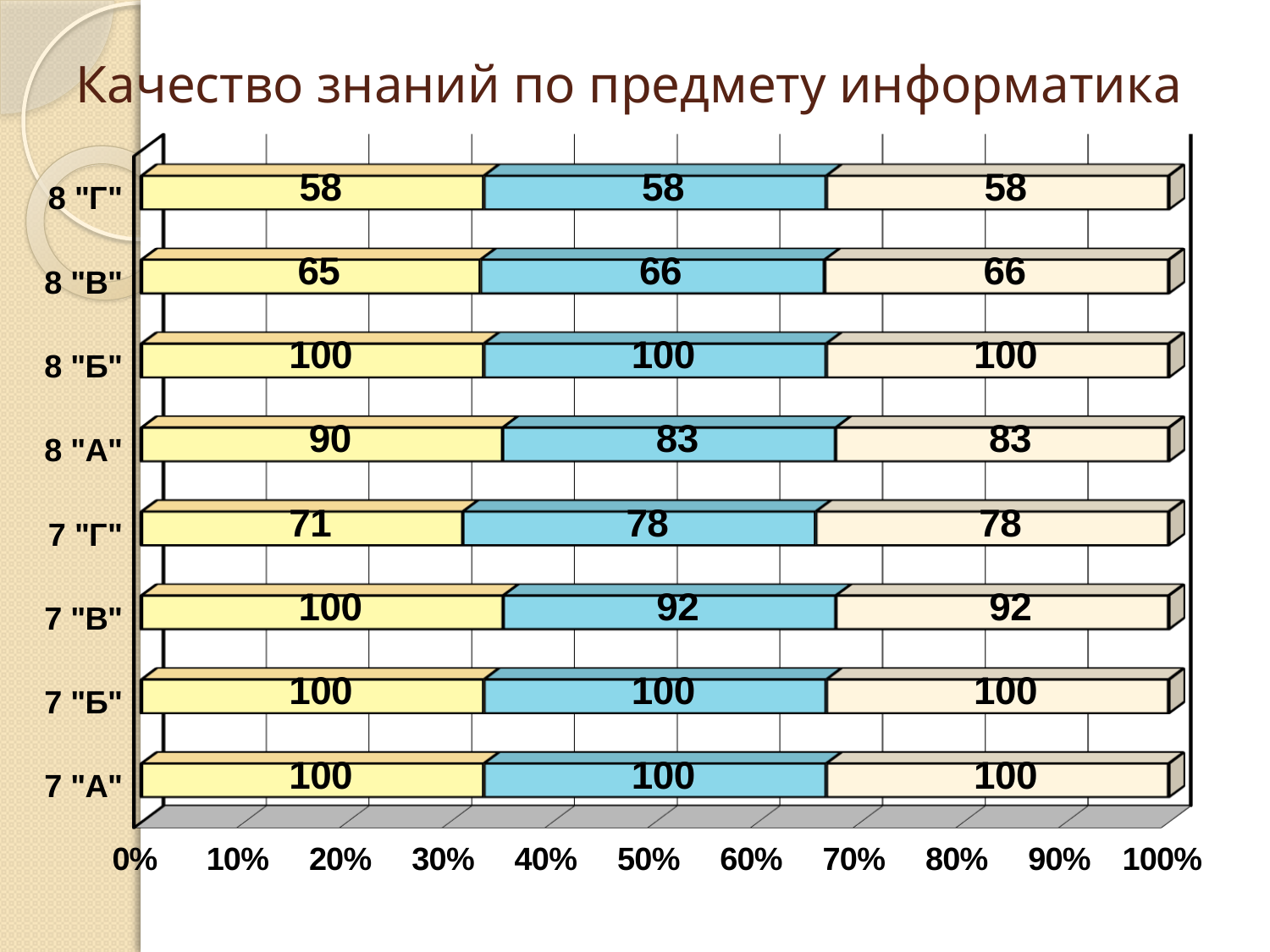
What is the value of the third (beige) segment for 7 "В"? 92 What is the value of the first (yellow) segment for 8 "А"? 90 For 7 "В", what is the difference between the yellow segment value and the blue segment value? 8 What is the title of the chart? Качество знаний по предмету информатика What is the value of the first (yellow) segment for 8 "В"? 65 Which class has the lowest value in the first (yellow) segment? 8 "Г" How many classes (categories) are shown on the chart? 8 For 7 "Г", which is larger: the yellow segment value or the blue segment value? the blue segment For 8 "А", what is the difference between the yellow segment value and the blue segment value? 7 How many coloured segments make up each bar? 3 What is the value of the second (blue) segment for 7 "Г"? 78 What kind of chart is shown on the slide? bar chart